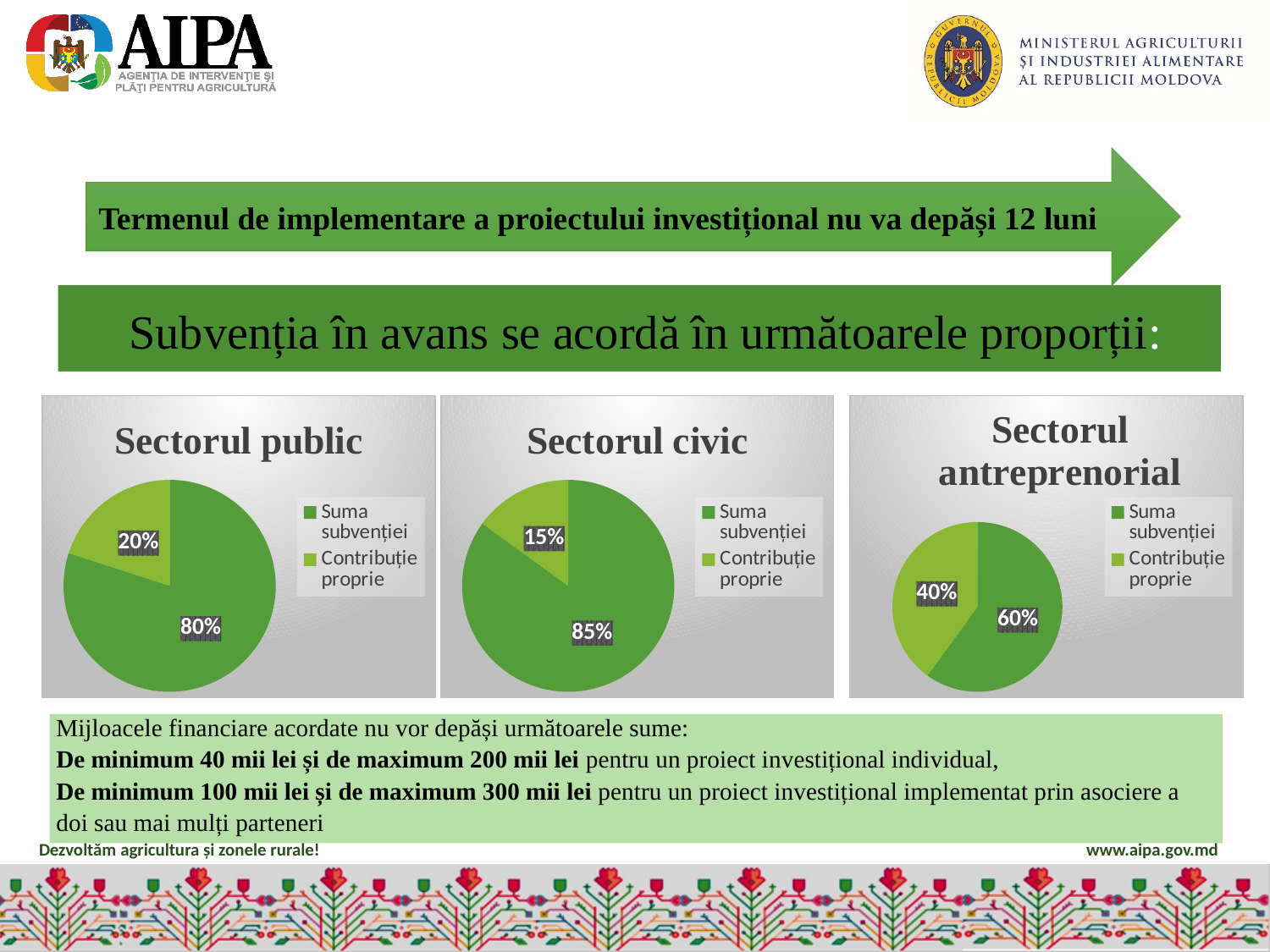
In the 'Sectorul antreprenorial' chart, which slice is the smallest? Contribuție proprie In the 'Sectorul civic' chart, what is the value for Suma subvenției? 85% In the 'Sectorul antreprenorial' chart, which is larger: Suma subvenției or Contribuție proprie? Suma subvenției What type of chart is the 'Sectorul civic' chart? Pie chart In the 'Sectorul public' chart, what is the value for Contribuție proprie? 20% In the 'Sectorul antreprenorial' chart, what is the value for Contribuție proprie? 40% How many slices does the 'Sectorul public' chart have? 2 In the 'Sectorul public' chart, what is the difference between Suma subvenției and Contribuție proprie? 60% In the 'Sectorul antreprenorial' chart, what is the value for Suma subvenției? 60% In the 'Sectorul public' chart, what is the value for Suma subvenției? 80% In the 'Sectorul civic' chart, which slice is the largest? Suma subvenției In the 'Sectorul civic' chart, what is the value for Contribuție proprie? 15%